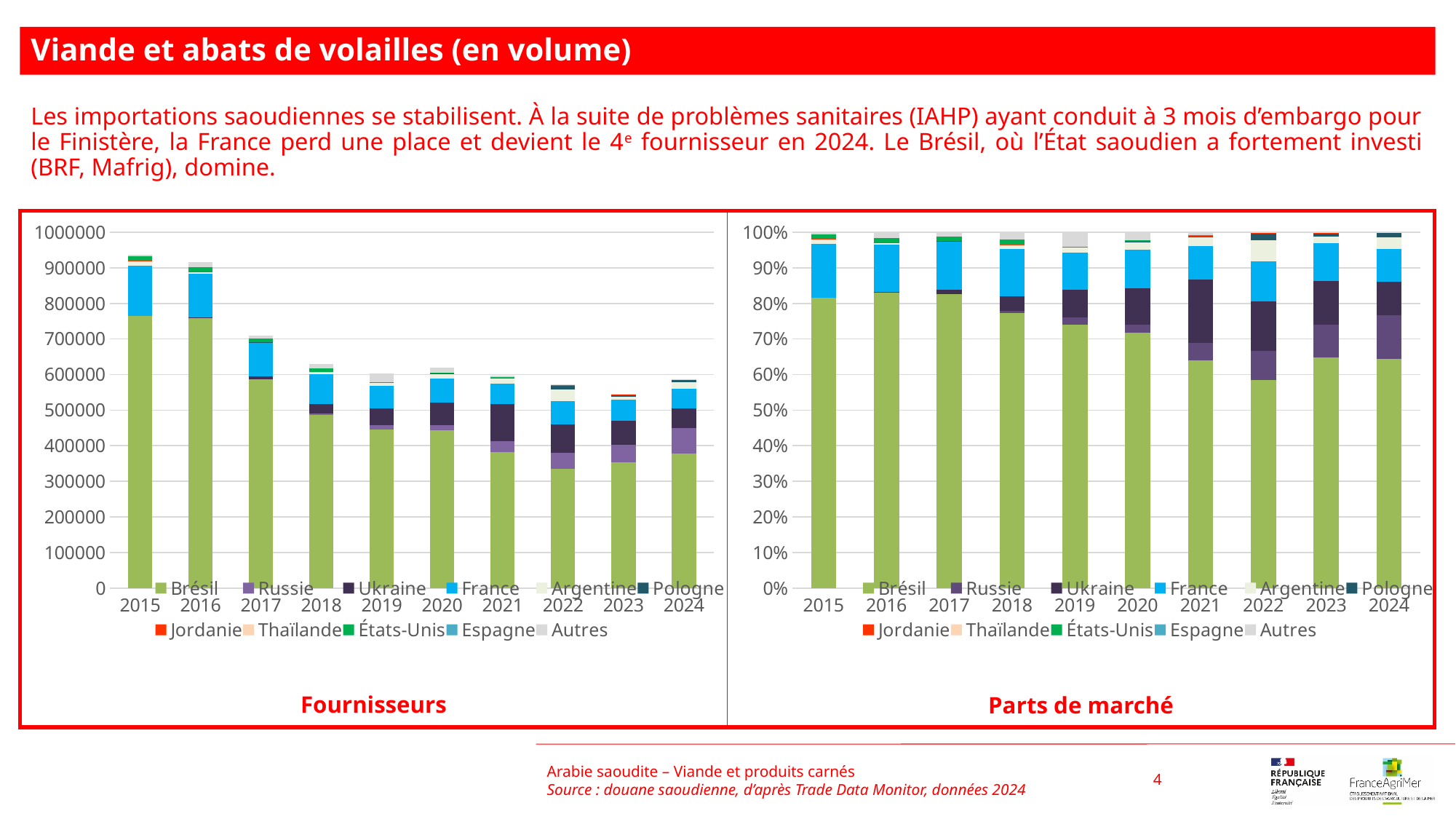
How many years are shown on the x axis of the 'Fournisseurs' chart? 10 In the 'Parts de marché' chart, which year has the lowest share for Brésil? 2022 In the 'Fournisseurs' chart, is the value for Brésil in 2022 greater or less than 400000? less In the 'Fournisseurs' chart, which year has the lowest total stacked bar? 2023 In the 'Parts de marché' chart, is the share for Brésil in 2024 greater or less than 70%? less In the 'Fournisseurs' chart, does the total volume rise or fall from 2015 to 2018? fall In the 'Fournisseurs' chart, is the total for 2017 greater or less than 800000? less In the 'Fournisseurs' chart, is the total bar for 2016 larger or smaller than the total bar for 2017? larger What kind of chart is the 'Fournisseurs' chart on the left? Stacked bar chart How many series does the legend of the 'Parts de marché' chart list? 11 In the 'Fournisseurs' chart, which year has the highest total stacked bar? 2015